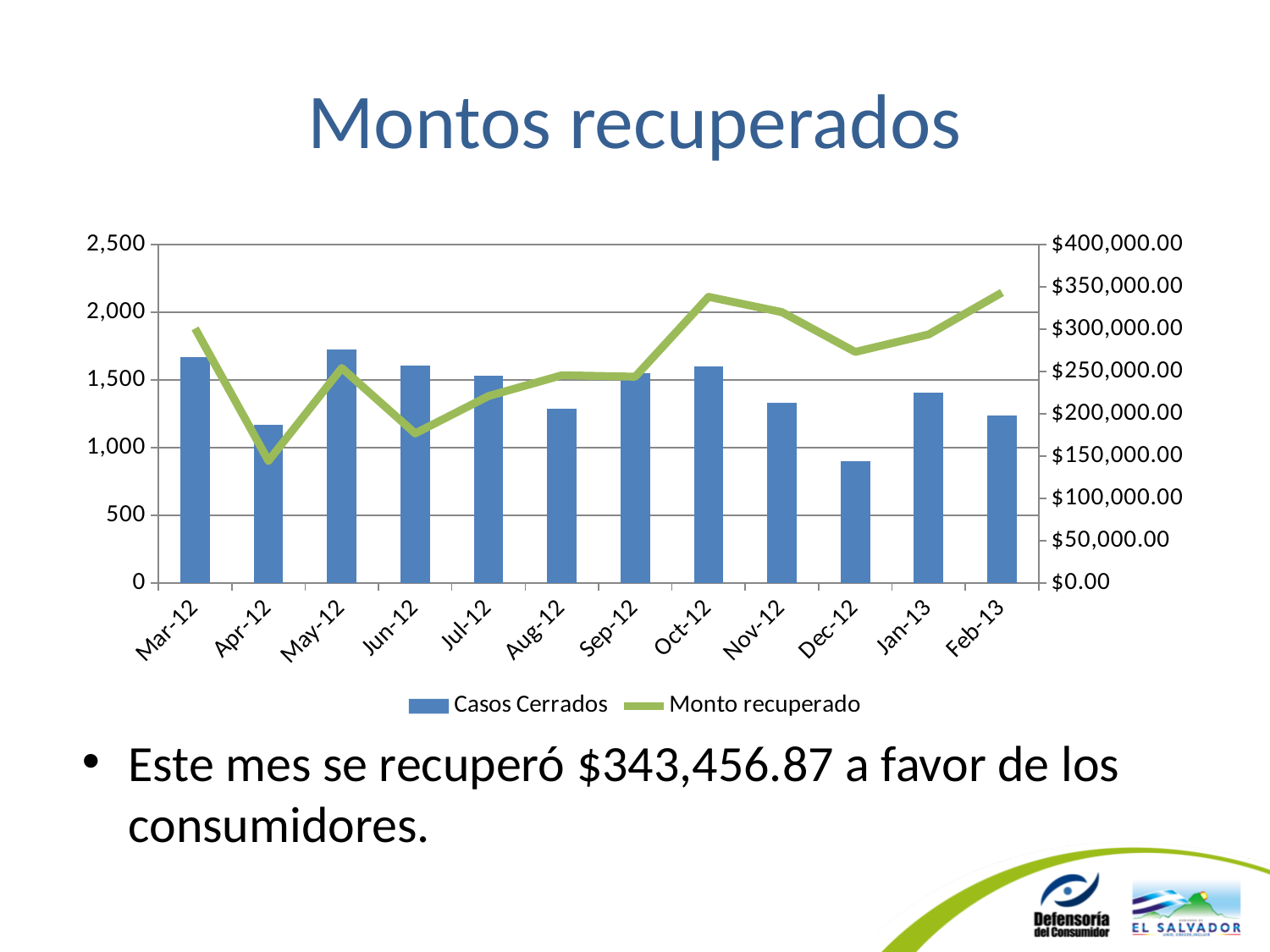
Which month has the lowest bar for Casos Cerrados? Dec-12 Which month has the highest bar for Casos Cerrados? May-12 How many months are shown along the x axis of the chart? 12 Is the Monto recuperado value for Apr-12 greater or less than $200,000.00? less How many series does the chart's legend list? 2 Which month has more Casos Cerrados, Apr-12 or Jun-12? Jun-12 In which month is the Monto recuperado line at its lowest point? Apr-12 Is the Monto recuperado value for Oct-12 greater or less than $300,000.00? greater Is the Casos Cerrados value for Dec-12 greater or less than 1,000? less What kind of chart is shown on the slide? A combined bar and line chart What is the title of the chart on the slide? Montos recuperados Does the Monto recuperado line rise or fall from Dec-12 to Feb-13? rise